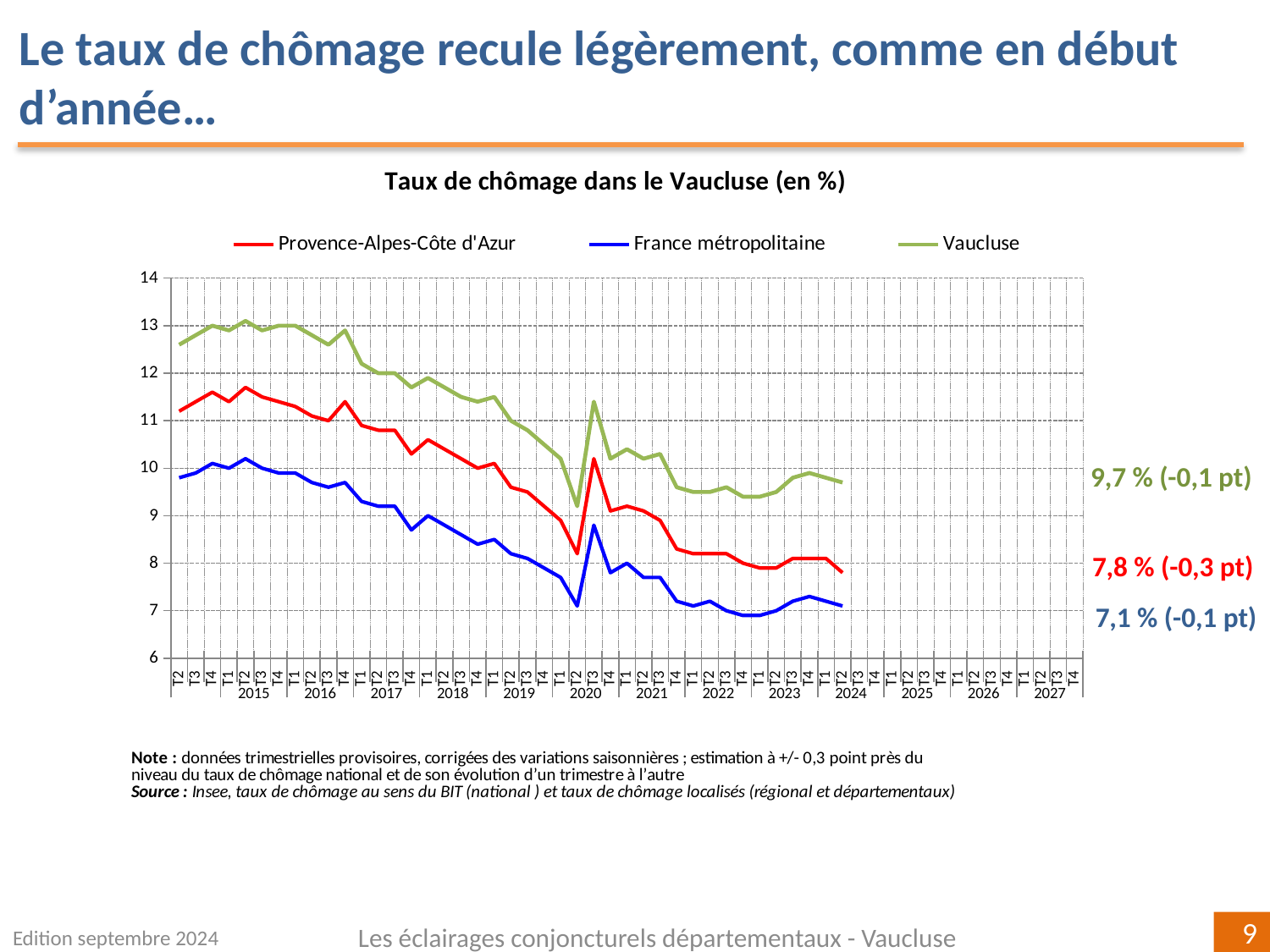
What is the latest unemployment rate shown for France métropolitaine? 7,1 % What is the latest unemployment rate shown for Provence-Alpes-Côte d'Azur? 7,8 % What kind of chart is shown on the slide? line chart Which series has the lowest values across the whole period? France métropolitaine What is the difference between the latest Vaucluse rate and the latest France métropolitaine rate? 2,6 points Overall, do the unemployment rates rise or fall from 2015 to 2024? fall How many series does the legend list? 3 By how much did the Provence-Alpes-Côte d'Azur rate change over the latest quarter, according to the label? -0,3 pt Is the value for Vaucluse in 2015 greater or less than 12? greater What is the title of the chart? Taux de chômage dans le Vaucluse (en %) What is the latest unemployment rate shown for Vaucluse? 9,7 % Which series has the highest values across the whole period? Vaucluse